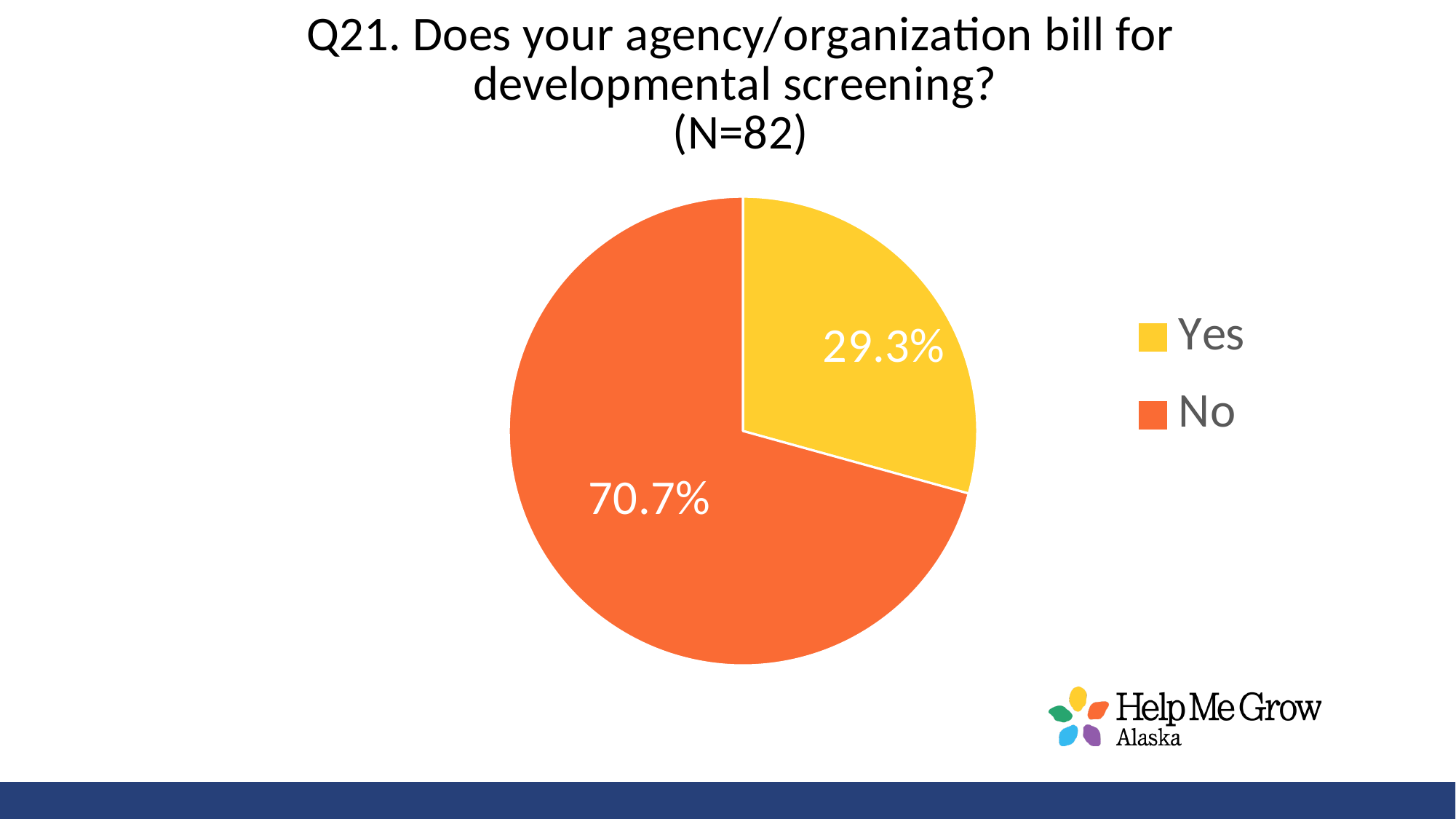
What is the difference in percentage points between the No and Yes slices? 41.4 What kind of chart is shown on the slide? pie chart What colour is the No slice in the pie chart? orange How many entries does the legend list? 2 What percentage of respondents answered Yes? 29.3% How many slices does the pie chart have? 2 What is the sample size (N) stated in the chart title? 82 Which response has the smallest share of the pie? Yes Which is larger, the Yes slice or the No slice? No What share of the pie does the Yes slice represent? 29.3% What percentage of respondents answered No? 70.7% Which response has the largest share of the pie? No